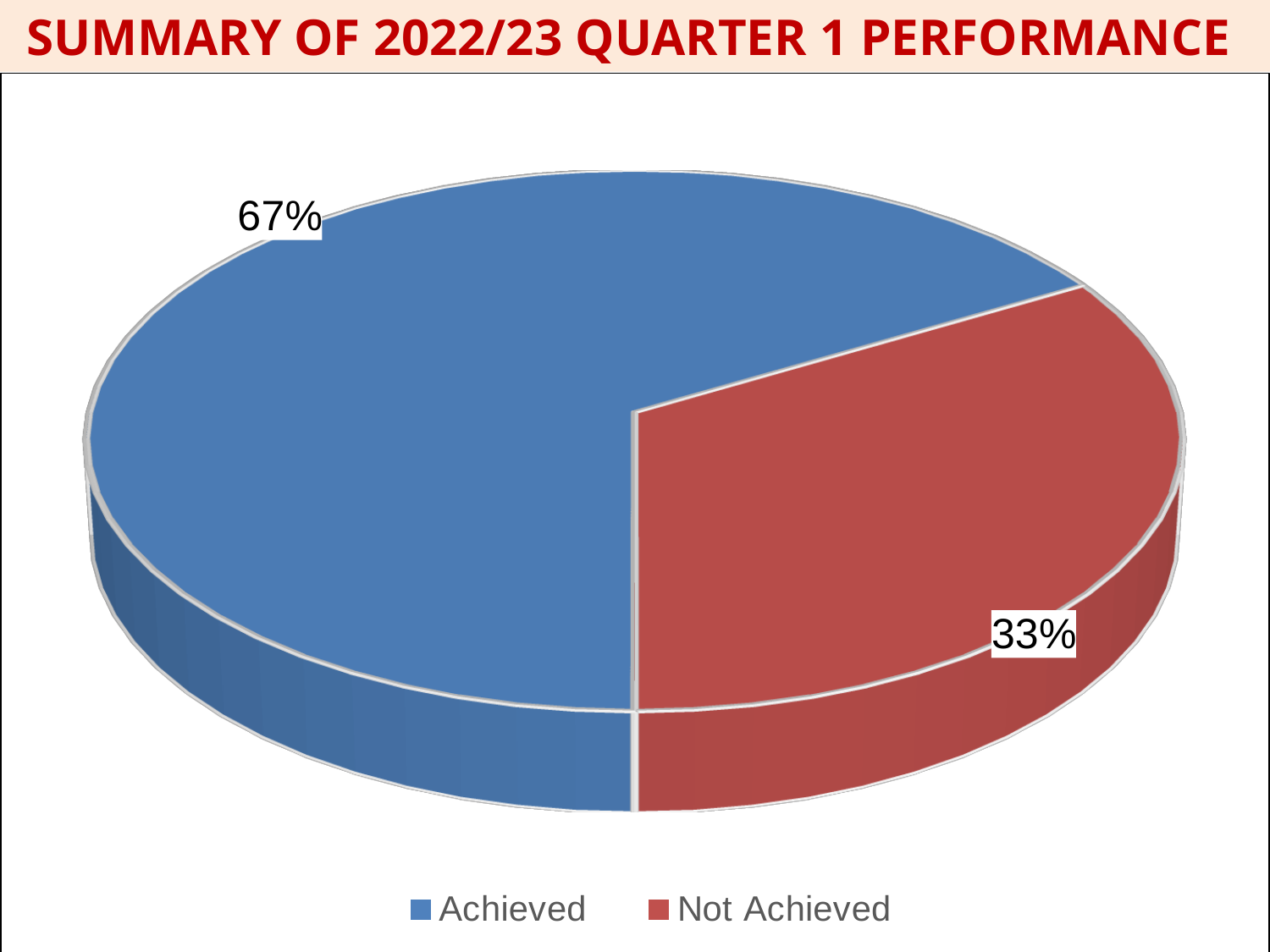
What kind of chart is shown on the slide? Pie chart Which is larger, the Achieved slice or the Not Achieved slice? Achieved What is the title of the slide? SUMMARY OF 2022/23 QUARTER 1 PERFORMANCE What percentage of the pie is labelled Achieved? 67% What colour is the Not Achieved slice? Red How many entries does the legend list? 2 Which slice of the pie is the smallest? Not Achieved How many slices does the pie chart have? 2 What percentage of the pie is labelled Not Achieved? 33% What share of the pie does the Not Achieved slice represent? 33% Which slice of the pie is the largest? Achieved What is the difference in percentage points between the Achieved and Not Achieved slices? 34